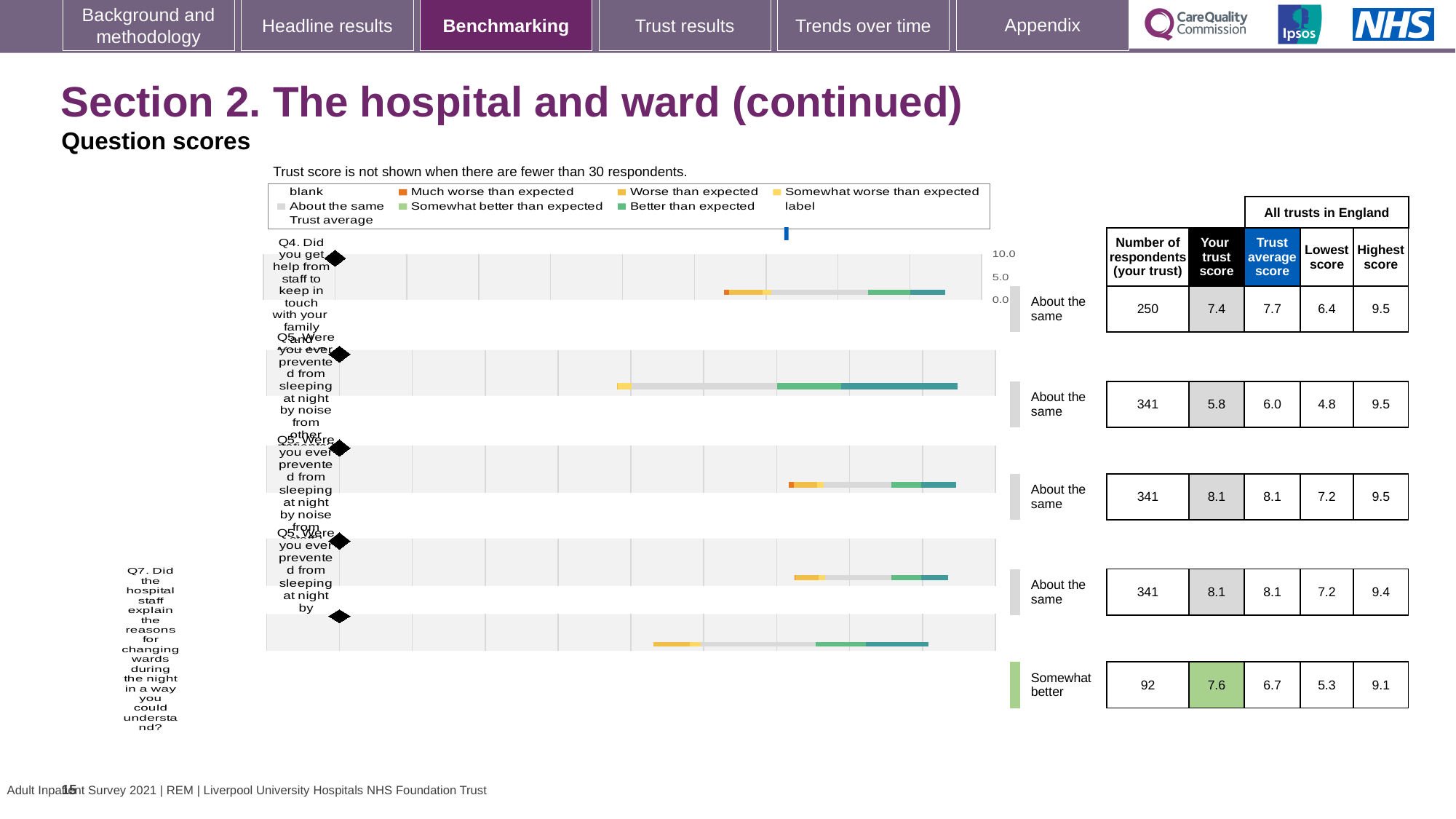
Which row has the lowest 'Your trust score'? the second row (5.8) For Q4 (the first row), which is larger: the trust score or the trust average score? the trust average score (7.7) What is the 'Your trust score' for Q7 (the last row of the chart)? 7.6 What is the highest score in England for Q7 (the last row)? 9.1 For Q7 (the last row), what is the difference between the trust score and the trust average score? 0.9 What kind of chart is used to show the question scores on this slide? bar chart What benchmark category is shown for Q7 (the last row)? Somewhat better How many question rows are plotted in the chart? 5 According to the note above the chart, below how many respondents is the trust score not shown? 30 What is the lowest score in England for the second row of the chart? 4.8 How many respondents are shown for Q4 (the first row)? 250 What is the 'Your trust score' for Q4 (the first row of the chart)? 7.4